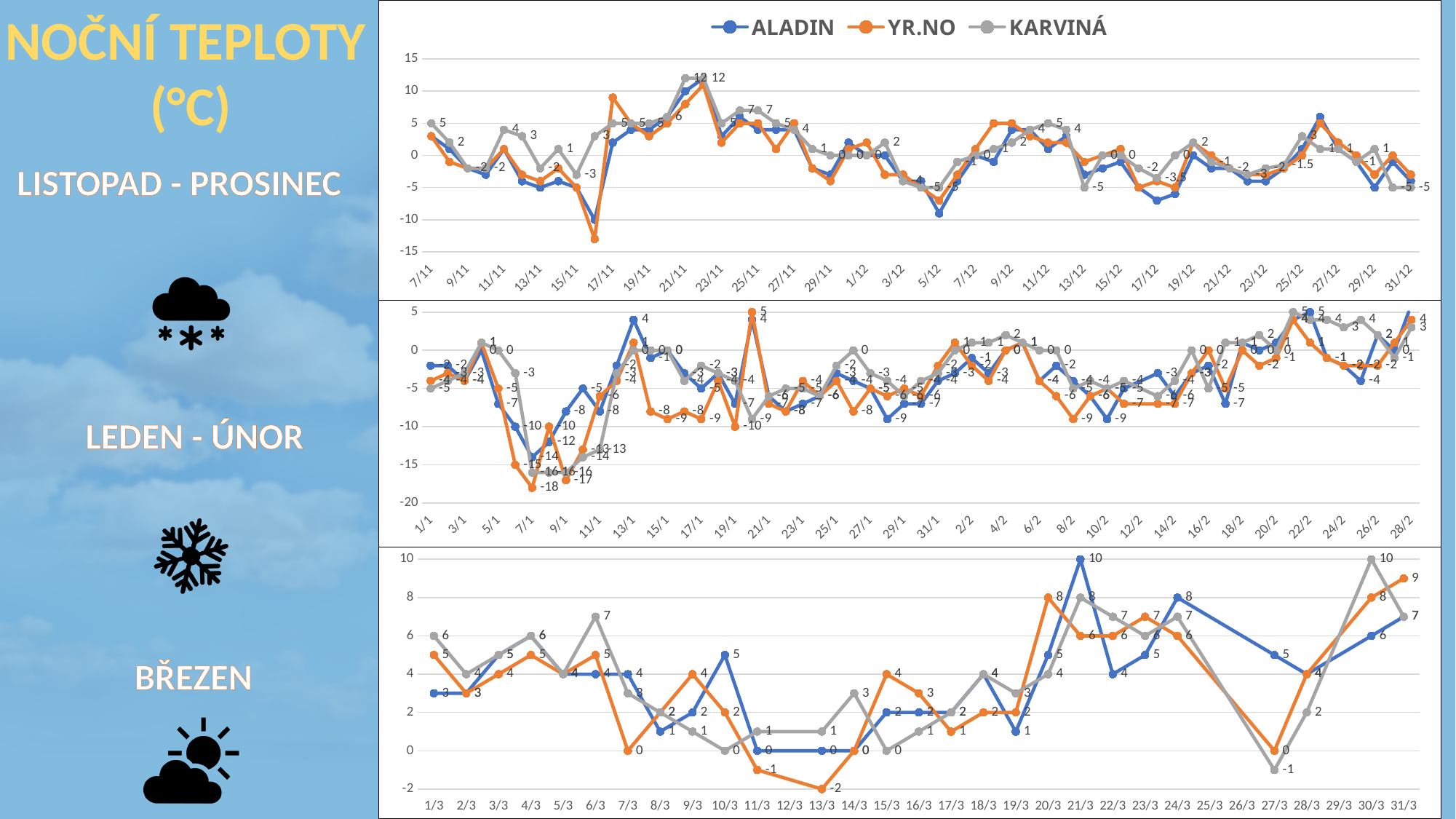
How many dates are shown on the x axis of the BŘEZEN (bottom) chart? 31 How many series does the legend at the top of the charts list? 3 In the BŘEZEN (bottom) chart, what is the ALADIN value on 21/3? 10 In the LEDEN - ÚNOR (middle) chart, what is the YR.NO value on 7/1? -18 In the BŘEZEN (bottom) chart, what is the YR.NO value on 13/3? -2 In the BŘEZEN (bottom) chart, which series has the higher value on 27/3, ALADIN or YR.NO? ALADIN What are the three series named in the legend? ALADIN, YR.NO, KARVINÁ In the BŘEZEN (bottom) chart, what is the difference between the ALADIN and YR.NO values on 21/3? 4 In the BŘEZEN (bottom) chart, what is the lowest YR.NO value? -2 What kind of chart is used for the BŘEZEN (bottom) chart? line chart In the BŘEZEN (bottom) chart, what is the KARVINÁ value on 30/3? 10 In the LISTOPAD - PROSINEC (top) chart, is the YR.NO value on 16/11 greater or less than -10? less